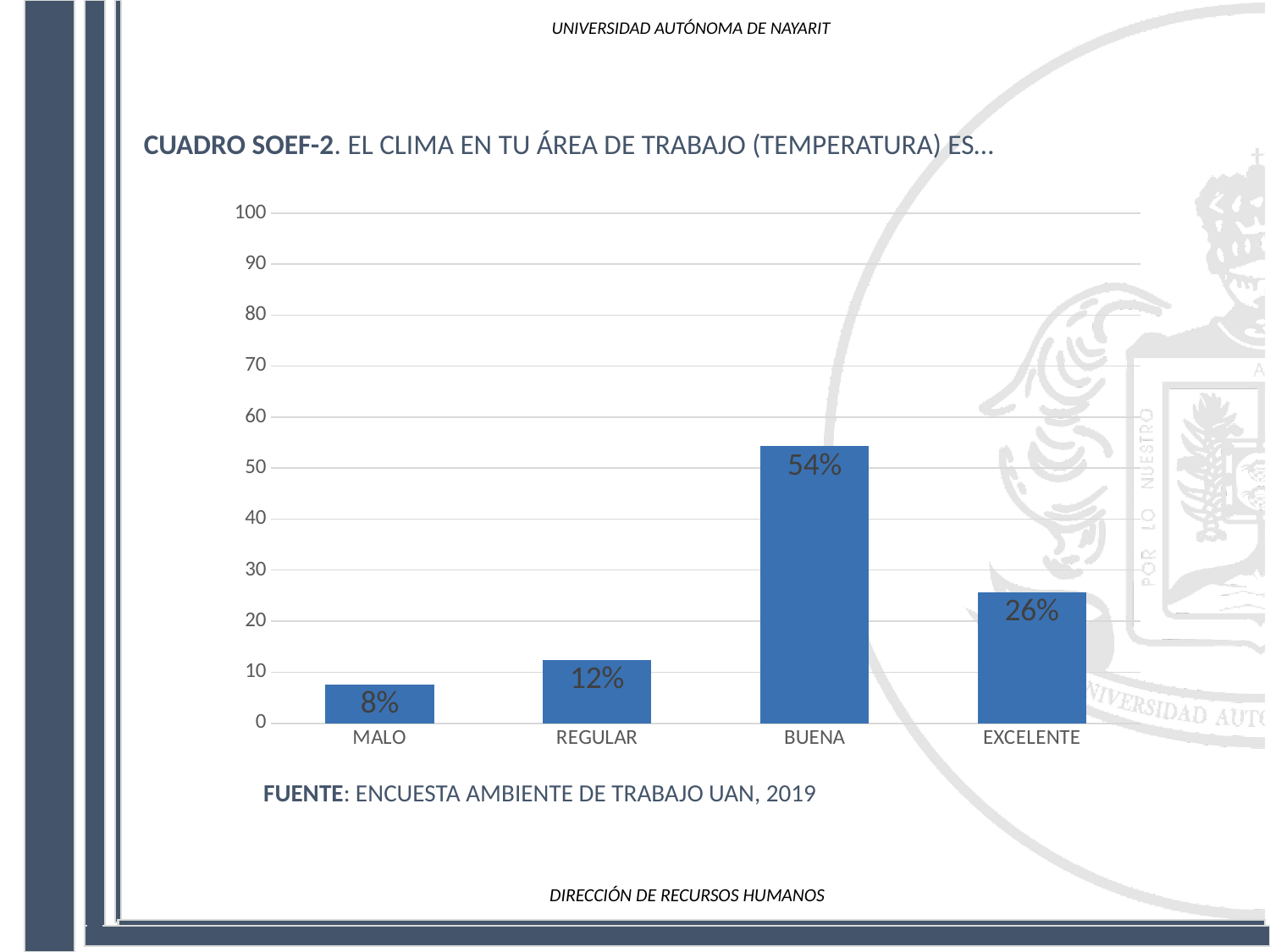
Is the value for BUENA greater or less than 50? greater What is the difference between the values for BUENA and EXCELENTE? 28% What is the value for BUENA? 54% What kind of chart is shown on the slide? bar chart Which is larger, the value for REGULAR or the value for EXCELENTE? EXCELENTE Which category has the lowest value? MALO What is the value for EXCELENTE? 26% What source is cited below the chart? ENCUESTA AMBIENTE DE TRABAJO UAN, 2019 What is the value for REGULAR? 12% How many categories are shown on the x axis? 4 Which category has the highest value? BUENA What is the value for MALO? 8%